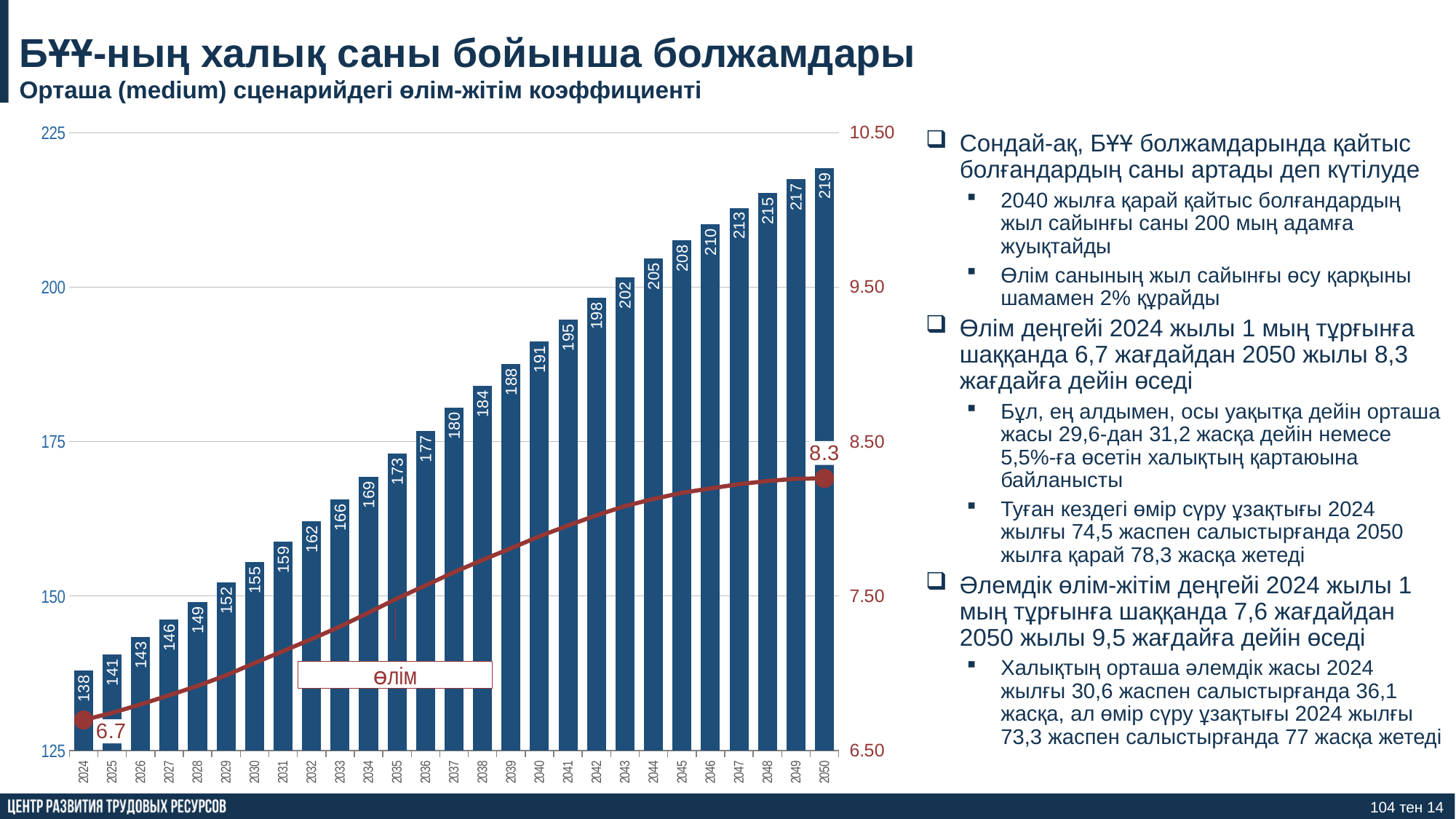
What is the difference between the bar values for 2050 and 2024? 81 What is the value of the line series (өлім) in 2050? 8.3 What is the bar value for 2040? 191 How many years (bars) are shown on the x axis? 27 What is the bar value for 2050? 219 Which year has the highest bar value? 2050 Do the bar values rise or fall from 2024 to 2050? rise Which is larger, the bar value for 2035 or the bar value for 2030? 2035 What is the value of the line series (өлім) in 2024? 6.7 Which year has the lowest bar value? 2024 What is the label shown on the line series in the chart? өлім What is the bar value for 2024? 138